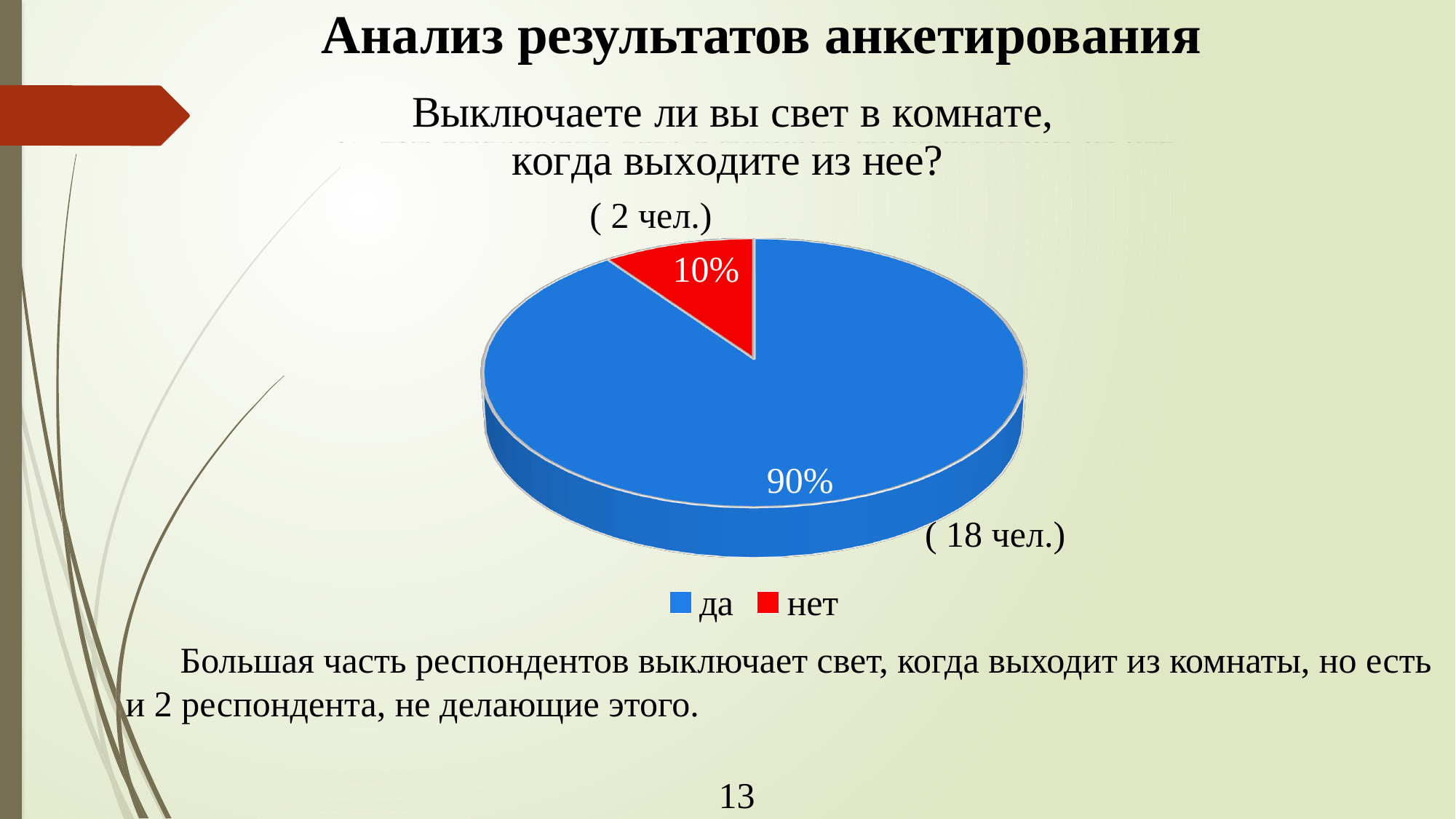
What is the difference in percentage points between the "да" and "нет" slices? 80 Which slice is larger, "да" or "нет"? да What kind of chart is shown on the slide? pie chart Which answer has the largest share of the pie? да How many categories does the pie chart have? 2 Which answer has the smallest share of the pie? нет What percentage of respondents answered "да"? 90% What percentage of respondents answered "нет"? 10% How many people answered "да"? 18 чел. How many entries does the legend list? 2 What colour is the "нет" slice? red How many people answered "нет"? 2 чел.